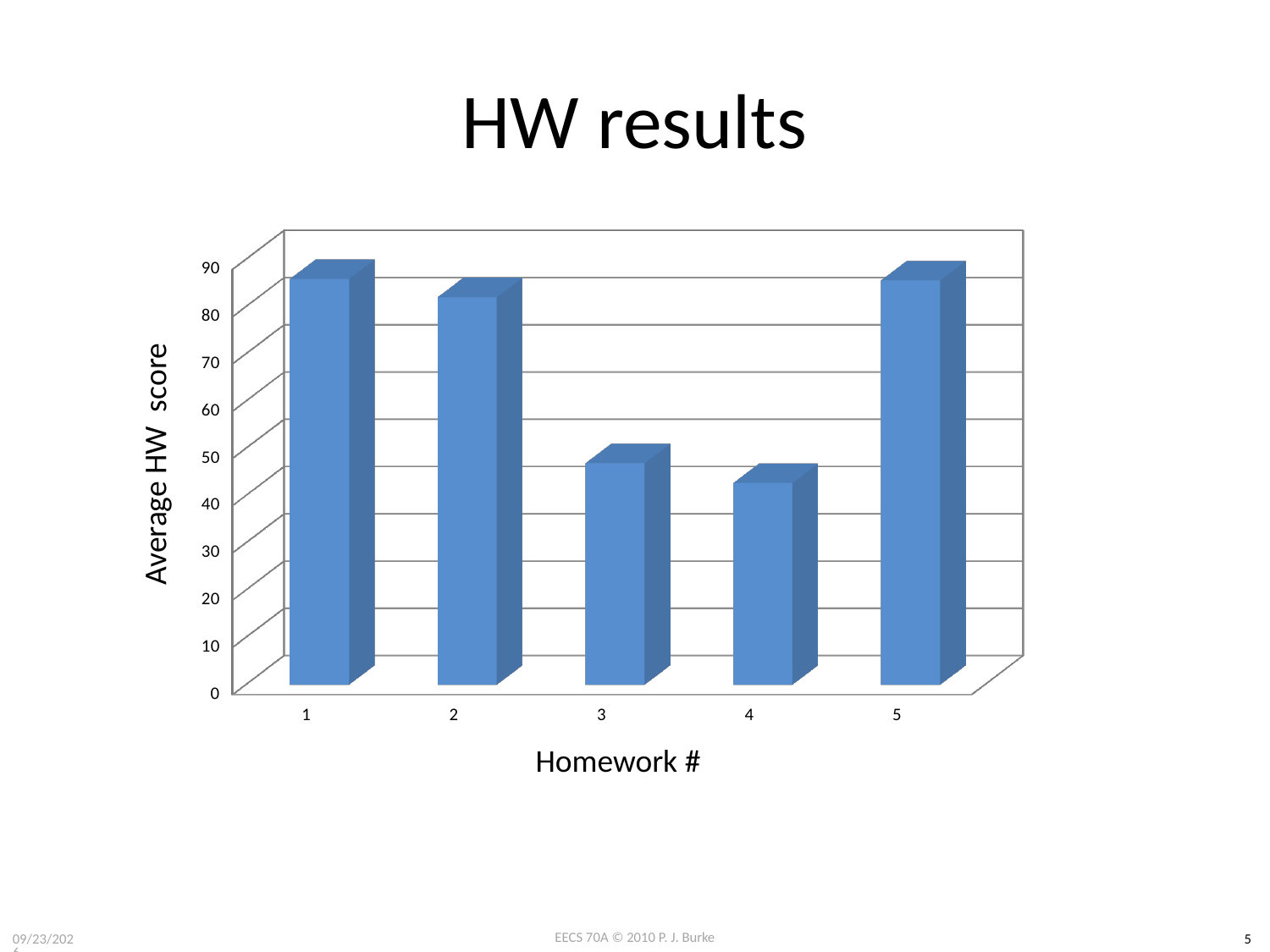
What is the label on the vertical axis of the chart? Average HW score Which has a higher average HW score, homework 2 or homework 3? homework 2 What type of chart is shown on the slide? bar chart Is the average HW score for homework 3 greater or less than 60? less What is the title of the chart? HW results Is the average HW score for homework 5 greater or less than 80? greater Is the average HW score for homework 4 greater or less than 50? less How many homework assignments are plotted on the chart? 5 Which homework number has the lowest average HW score? 4 Which has a higher average HW score, homework 4 or homework 5? homework 5